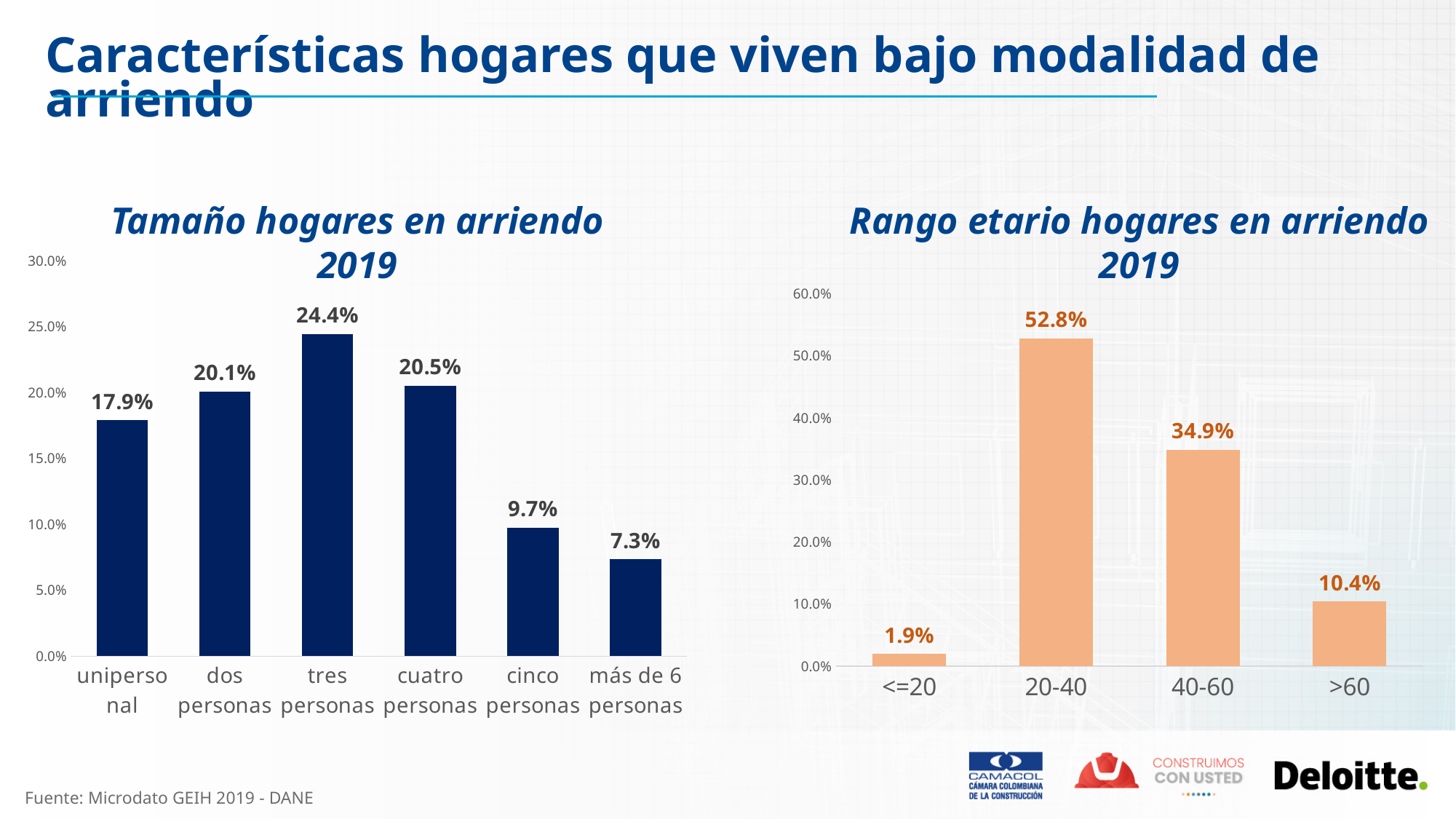
In the 'Tamaño hogares en arriendo 2019' chart, how many categories are shown? 6 In the 'Rango etario hogares en arriendo 2019' chart, which age range has the highest value? 20-40 In the 'Tamaño hogares en arriendo 2019' chart, what is the value for más de 6 personas? 7.3% In the 'Rango etario hogares en arriendo 2019' chart, which is larger, the value for 40-60 or the value for >60? 40-60 What kind of chart is the 'Rango etario hogares en arriendo 2019' chart? bar chart In the 'Rango etario hogares en arriendo 2019' chart, what is the value for <=20? 1.9% In the 'Rango etario hogares en arriendo 2019' chart, what is the difference between the values for 20-40 and 40-60? 17.9% In the 'Tamaño hogares en arriendo 2019' chart, what is the value for tres personas? 24.4% In the 'Tamaño hogares en arriendo 2019' chart, what is the difference between the values for tres personas and unipersonal? 6.5% In the 'Tamaño hogares en arriendo 2019' chart, which category has the highest value? tres personas In the 'Rango etario hogares en arriendo 2019' chart, what is the value for 40-60? 34.9% In the 'Tamaño hogares en arriendo 2019' chart, which category has the lowest value? más de 6 personas